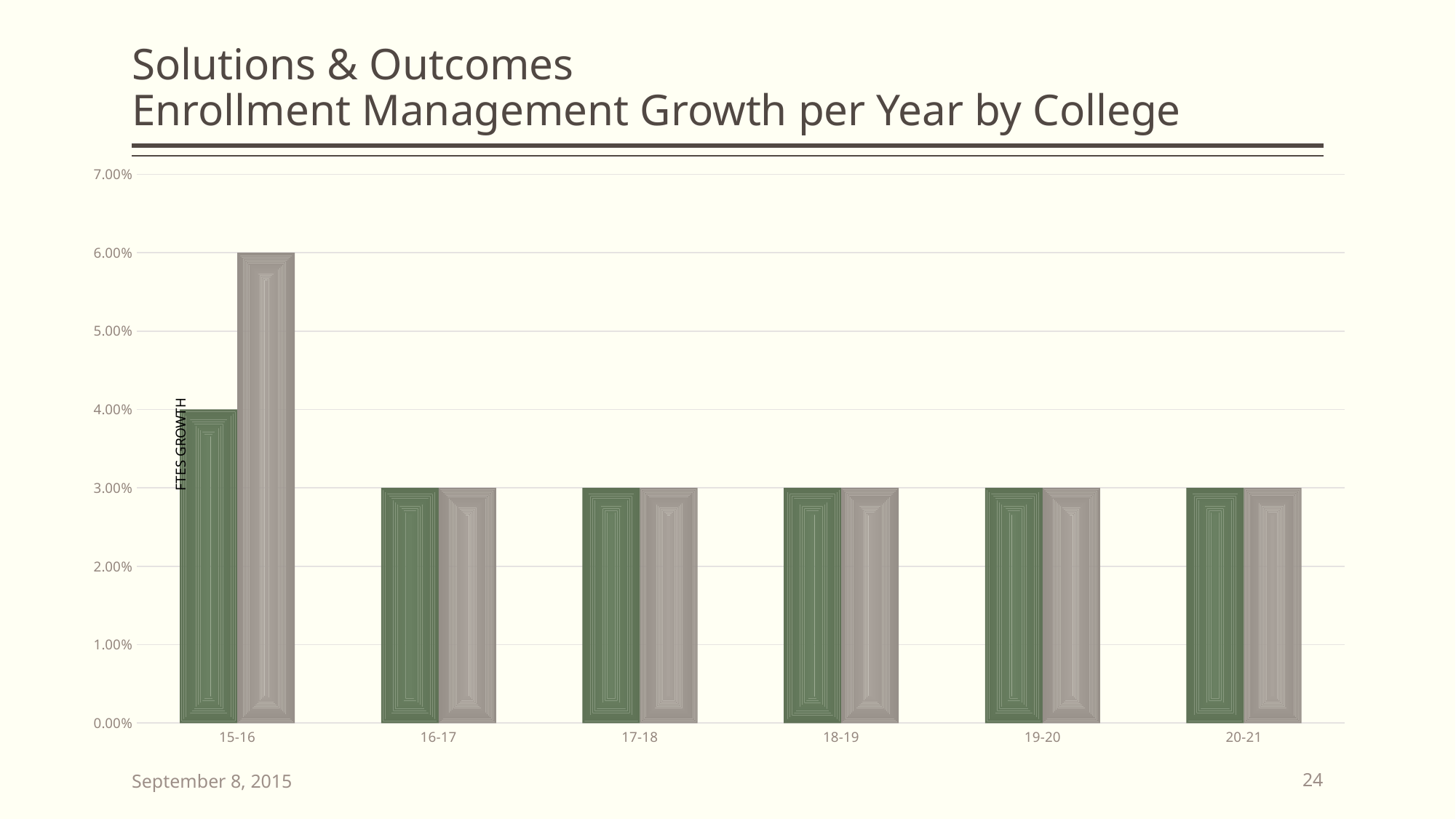
Do the grey bar values rise or fall from 15-16 to 16-17? fall What is the value of the green bar for 18-19? 3.00% What is the label on the vertical axis? FTES GROWTH What is the difference between the grey bar and the green bar for 15-16? 2.00% What is the value of the grey bar for 20-21? 3.00% What is the value of the green bar for 15-16? 4.00% For 15-16, which is larger, the green bar or the grey bar? the grey bar Which year has the highest green bar? 15-16 How many year categories are shown on the x axis? 6 What kind of chart is shown on the slide? bar chart What is the value of the grey bar for 15-16? 6.00% Which year has the highest grey bar? 15-16